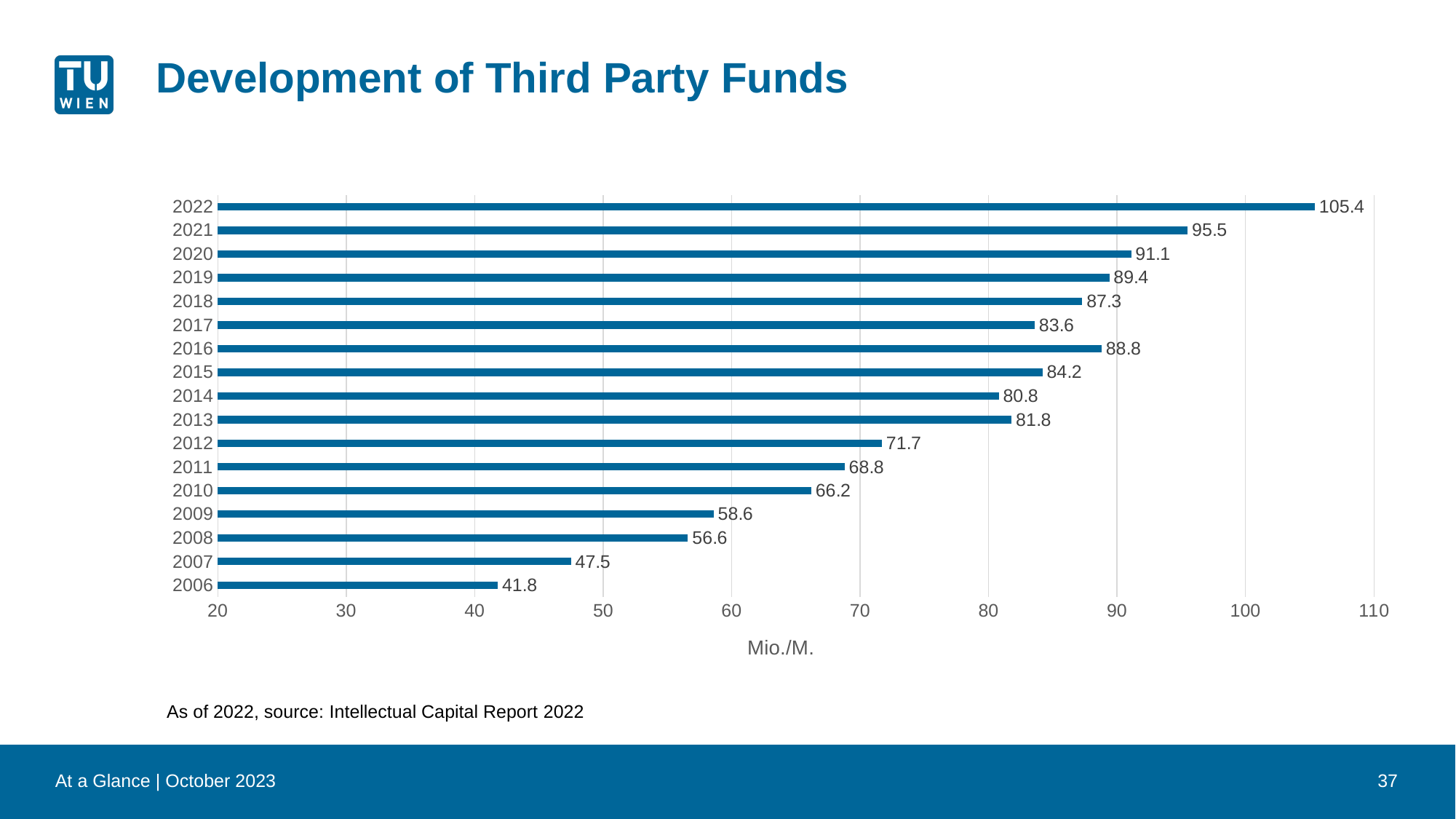
Which year has the lowest value? 2006 What is the difference between the values for 2022 and 2021? 9.9 What is the label on the horizontal axis? Mio./M. What is the value for 2022? 105.4 What kind of chart is shown on the slide? bar chart What is the value for 2016? 88.8 How many years are shown in the chart? 17 Is the value for 2012 greater or less than 70? greater What is the difference between the values for 2013 and 2014? 1.0 Which is larger, the value for 2016 or the value for 2017? 2016 Which year has the highest value? 2022 What is the value for 2006? 41.8